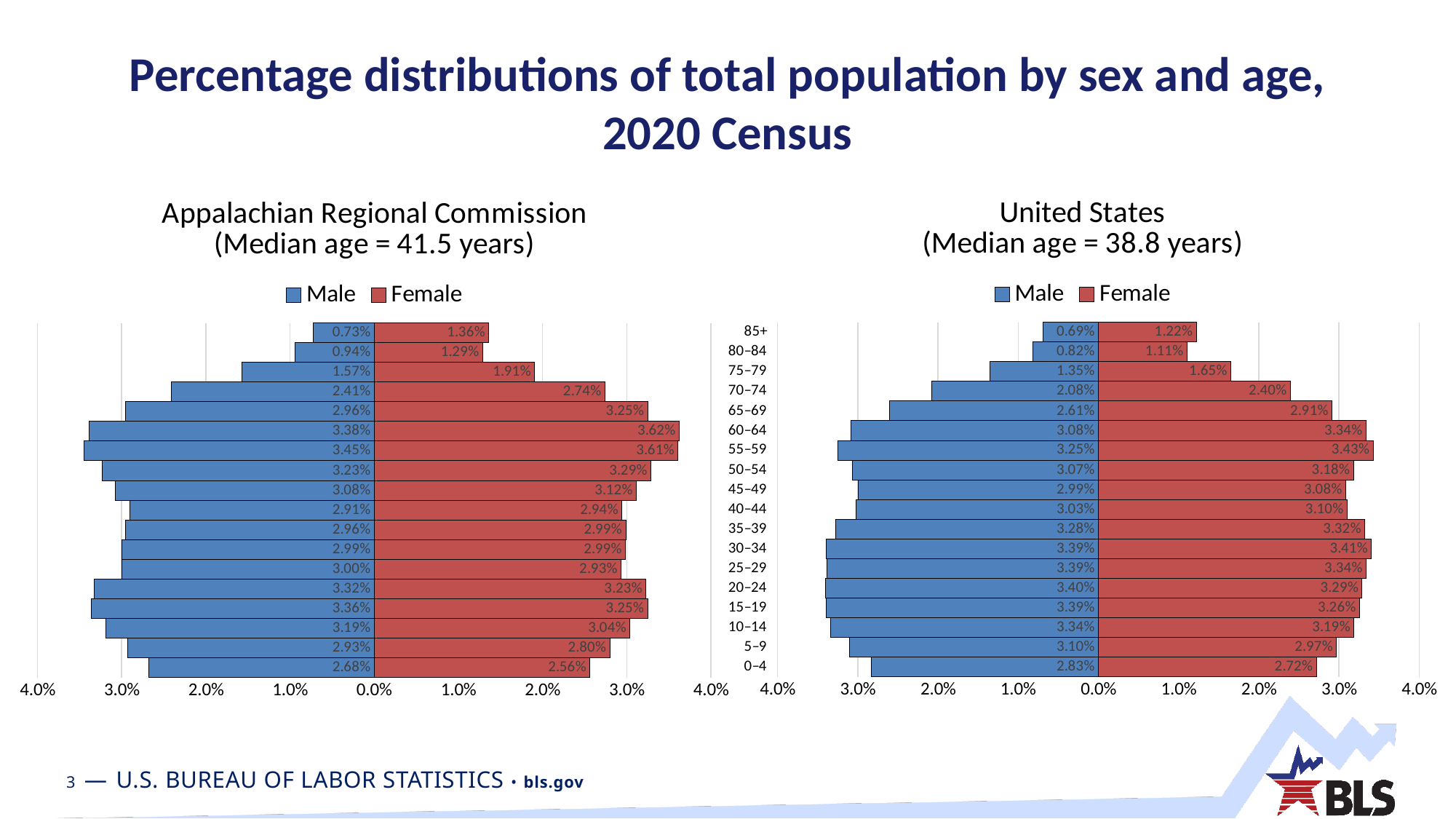
What kind of chart is the United States chart? Bar chart In the United States chart, what is the Female value for the 55–59 age group? 3.43% How many age groups are shown in the United States chart? 18 In the Appalachian Regional Commission chart, what is the Male value for the 85+ age group? 0.73% How many series does the legend of the Appalachian Regional Commission chart list? 2 What median age is given in the subtitle of the Appalachian Regional Commission chart? 41.5 years In the United States chart, which age group has the lowest Male value? 85+ In the United States chart, what is the difference between the Male values for the 20–24 and 85+ age groups? 2.71% In the Appalachian Regional Commission chart, is the Male value for the 55–59 age group greater or less than 3.0%? greater In the United States chart, which is larger for the 0–4 age group, the Male value or the Female value? Male In the Appalachian Regional Commission chart, what is the difference between the Female and Male values for the 85+ age group? 0.63% In the Appalachian Regional Commission chart, which age group has the highest Female value? 60–64